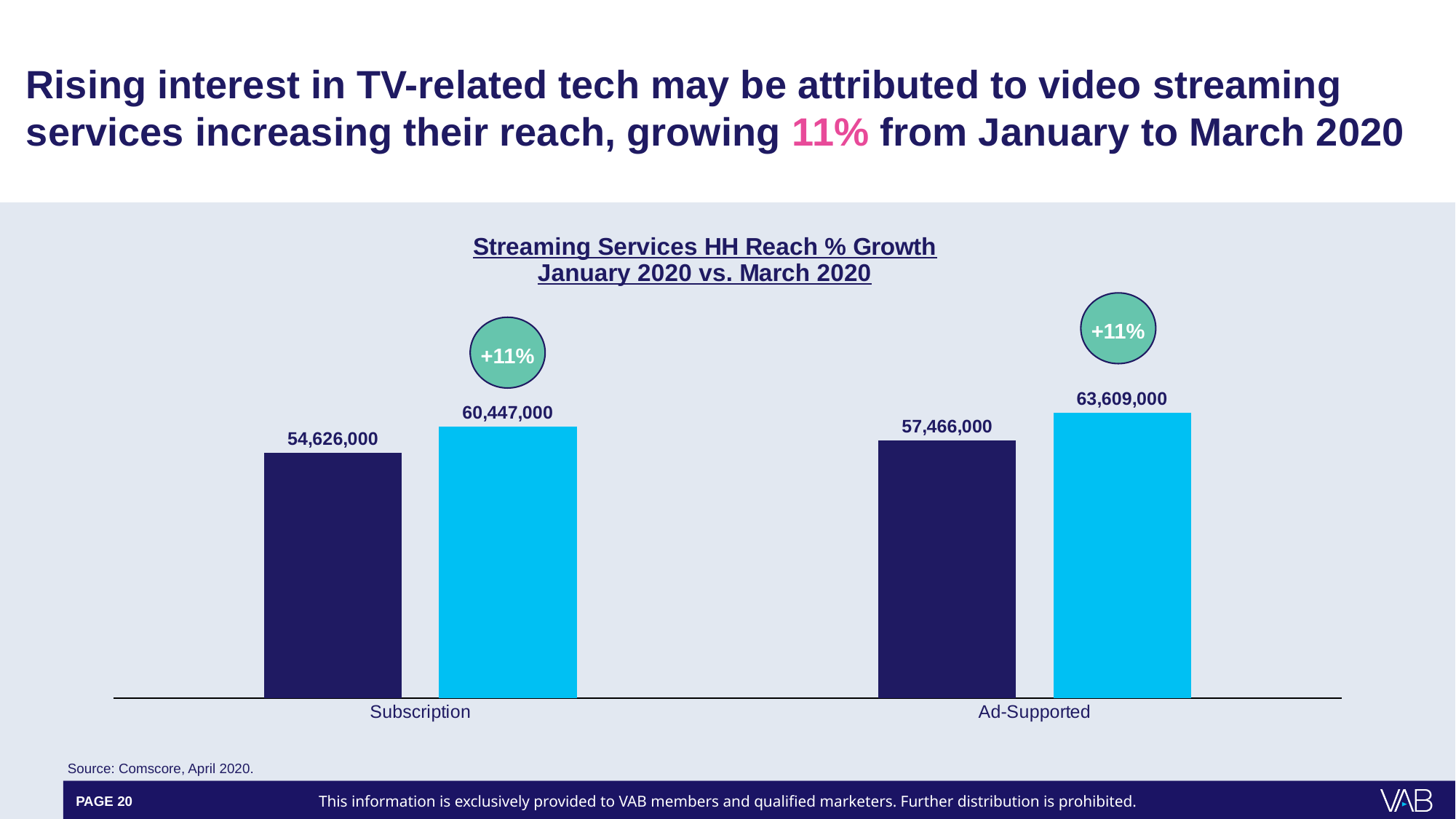
What is the value of the dark navy (left) bar for Ad-Supported? 57,466,000 What type of chart is shown on the slide? Bar chart Which bar has the highest value in the chart? Ad-Supported light blue bar (63,609,000) What is the value of the dark navy (left) bar for Subscription? 54,626,000 What is the value of the light blue (right) bar for Ad-Supported? 63,609,000 How many categories are shown on the x axis of the chart? 2 What is the difference between the light blue and dark navy bars for Ad-Supported? 6,143,000 What is the difference between the light blue and dark navy bars for Subscription? 5,821,000 What is the title of the chart? Streaming Services HH Reach % Growth January 2020 vs. March 2020 What growth percentage is shown in the circle above the Ad-Supported bars? +11% What is the value of the light blue (right) bar for Subscription? 60,447,000 Which bar has the lowest value in the chart? Subscription dark navy bar (54,626,000)